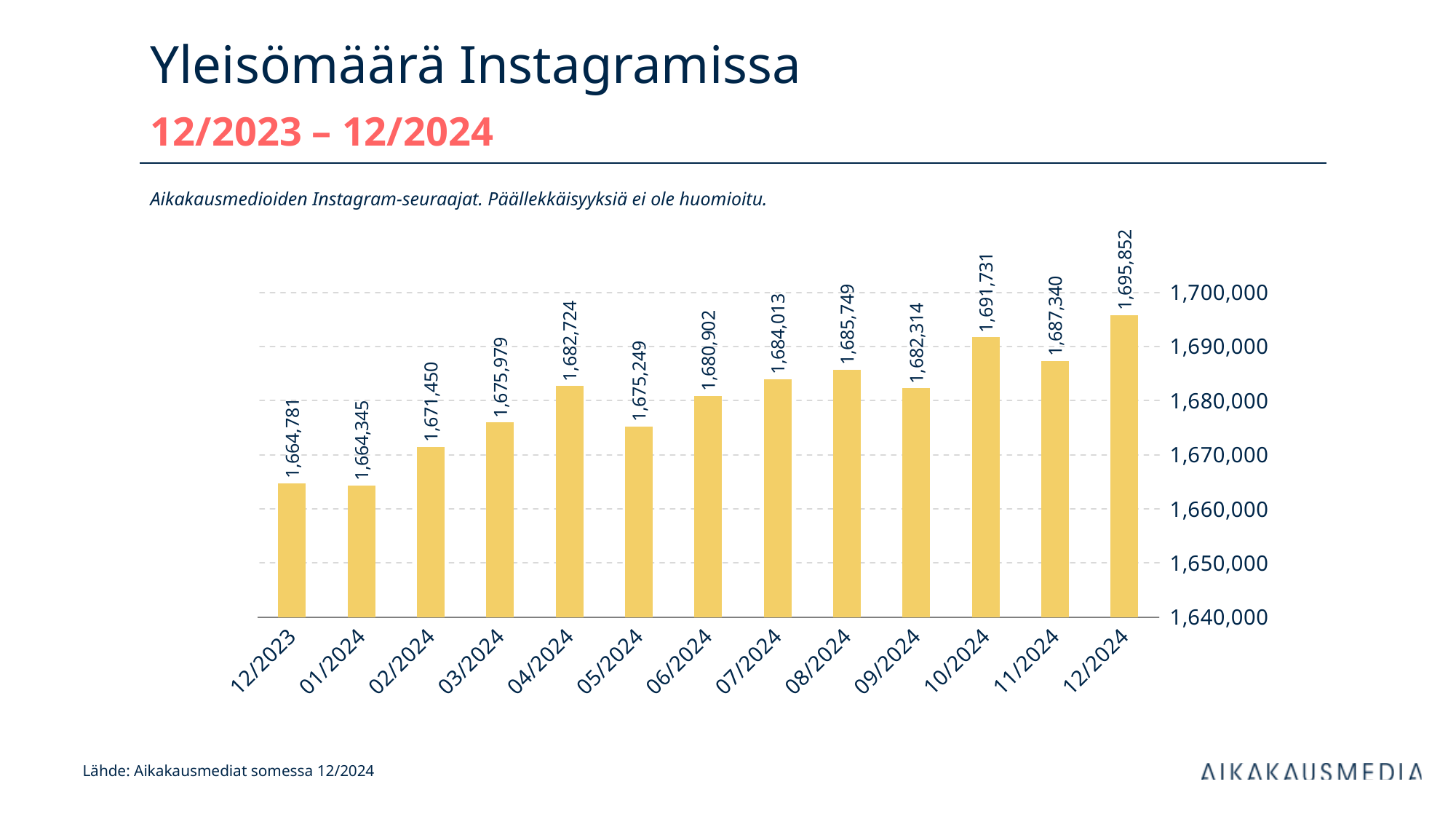
Which month has the highest value? 12/2024 What is the value for 12/2023? 1,664,781 Which is larger, the value for 08/2024 or the value for 09/2024? 08/2024 What kind of chart is shown on the slide? bar chart Do the values generally rise or fall from 12/2023 to 12/2024? rise What is the difference between the values for 12/2024 and 12/2023? 31,071 What is the difference between the values for 10/2024 and 11/2024? 4,391 What is the value for 04/2024? 1,682,724 What is the value for 12/2024? 1,695,852 How many months are shown on the x axis? 13 Which month has the lowest value? 01/2024 Is the value for 05/2024 greater or less than 1,680,000? less